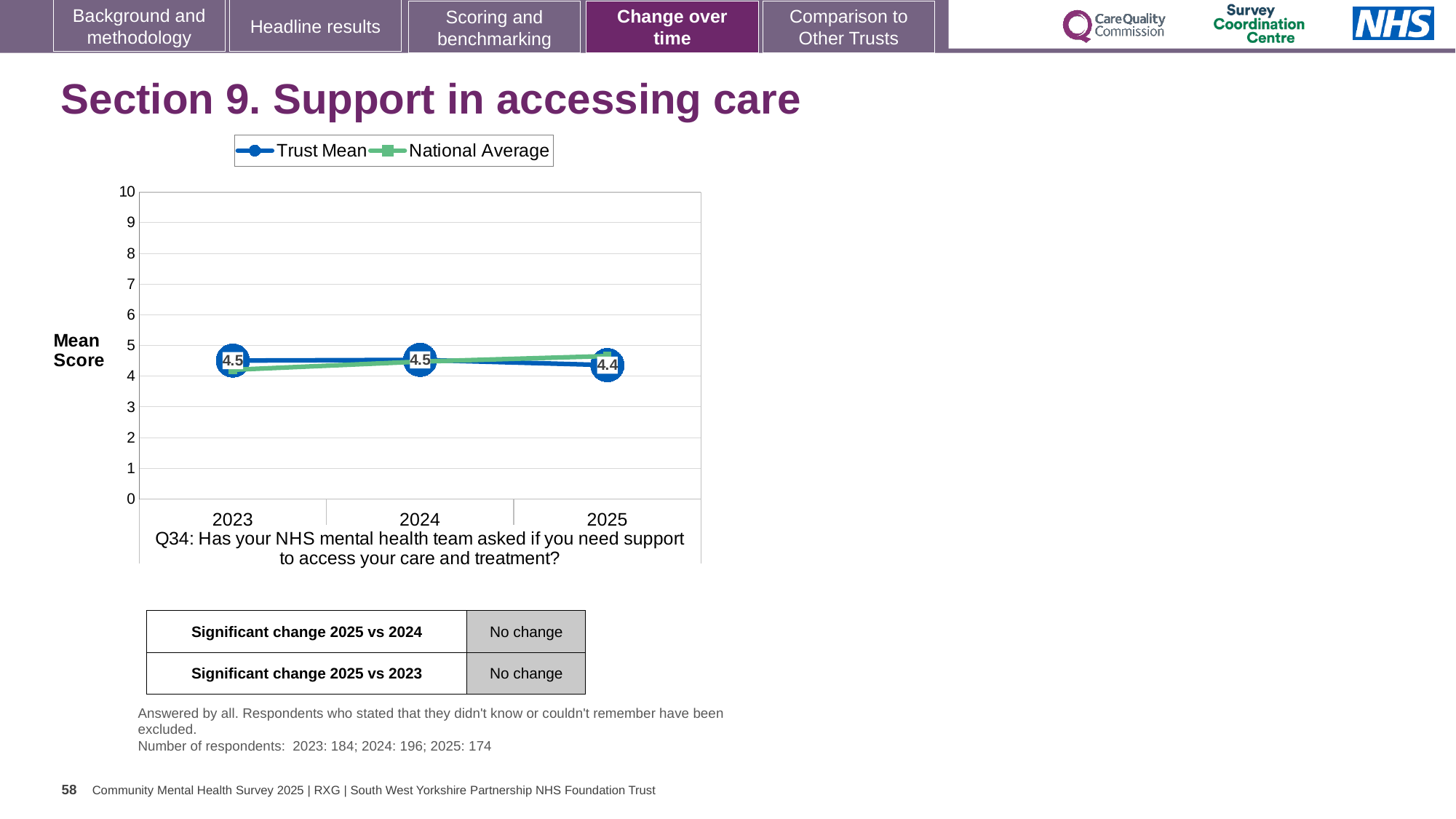
What kind of chart is shown on the slide? Line chart What is the Trust Mean score for 2024? 4.5 What is the Trust Mean score for 2025? 4.4 Is the National Average value for 2023 greater or less than 5? less Which is larger, the Trust Mean score for 2024 or for 2025? 2024 How many years are shown on the x axis of the chart? 3 How many series does the chart legend list? 2 What is the Trust Mean score for 2023? 4.5 Does the National Average line rise or fall from 2023 to 2025? Rise In which year is the Trust Mean score lowest? 2025 Is the Trust Mean value for 2024 greater or less than 4? greater What is the difference between the Trust Mean score in 2023 and in 2025? 0.1